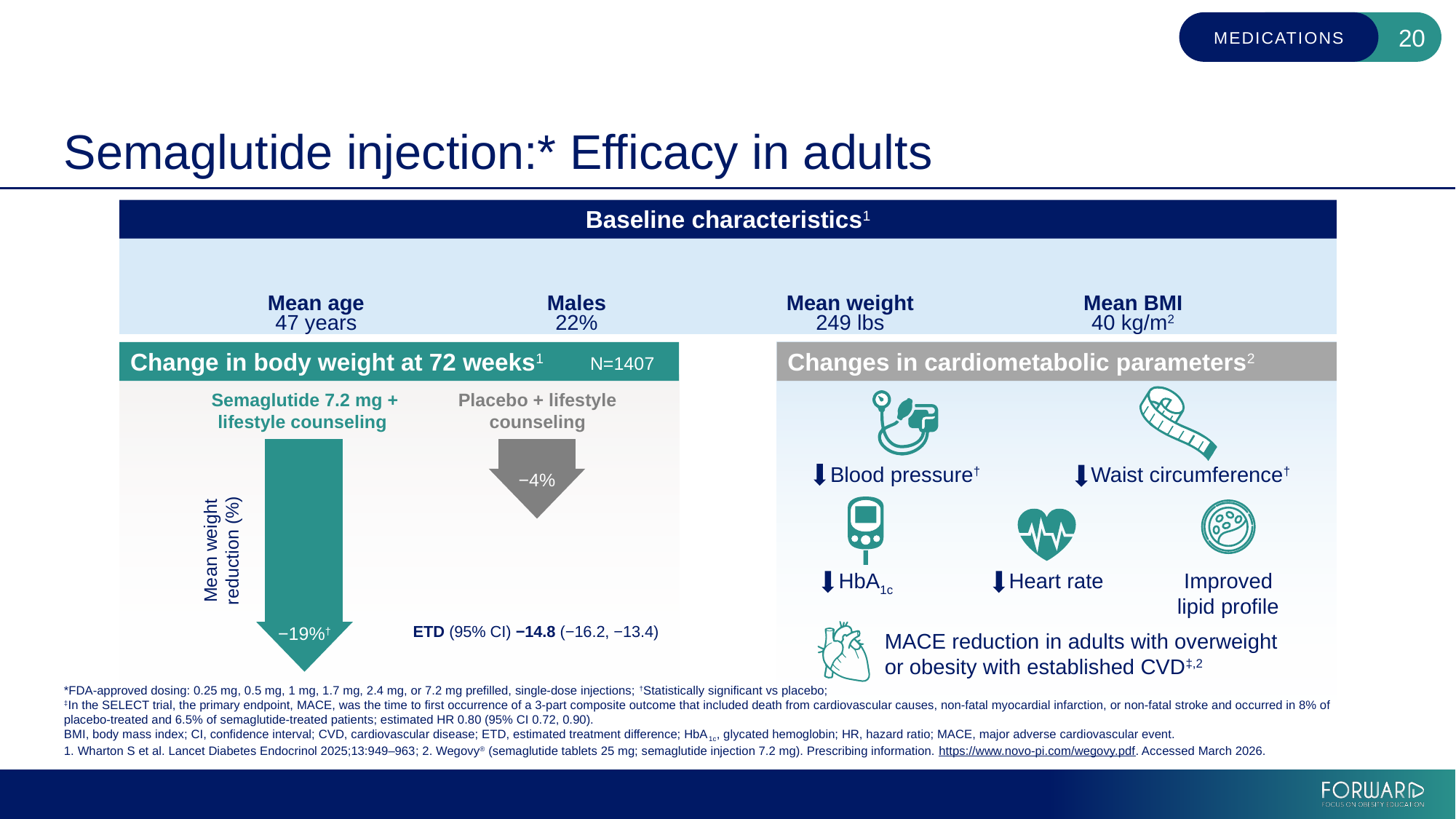
In the 'Change in body weight at 72 weeks' chart, which group shows the smaller mean weight reduction? Placebo + lifestyle counseling In the 'Change in body weight at 72 weeks' chart, is the weight reduction larger for semaglutide or for placebo? Semaglutide In the 'Change in body weight at 72 weeks' chart, is the semaglutide weight reduction greater or less than 10%? greater In the 'Change in body weight at 72 weeks' chart, what is the mean weight reduction for Placebo + lifestyle counseling? −4% How many treatment groups are shown in the 'Change in body weight at 72 weeks' chart? 2 What is the label on the vertical axis of the 'Change in body weight at 72 weeks' chart? Mean weight reduction (%) In the 'Change in body weight at 72 weeks' chart, what is the mean weight reduction for Semaglutide 7.2 mg + lifestyle counseling? −19% In the 'Change in body weight at 72 weeks' chart, what is the difference in percentage points between the semaglutide and placebo weight reductions? 15 percentage points In the 'Change in body weight at 72 weeks' chart, which group shows the larger mean weight reduction? Semaglutide 7.2 mg + lifestyle counseling What is the N value shown in the header of the 'Change in body weight at 72 weeks' chart? N=1407 What is the estimated treatment difference (ETD) shown below the 'Change in body weight at 72 weeks' chart? −14.8 (−16.2, −13.4)